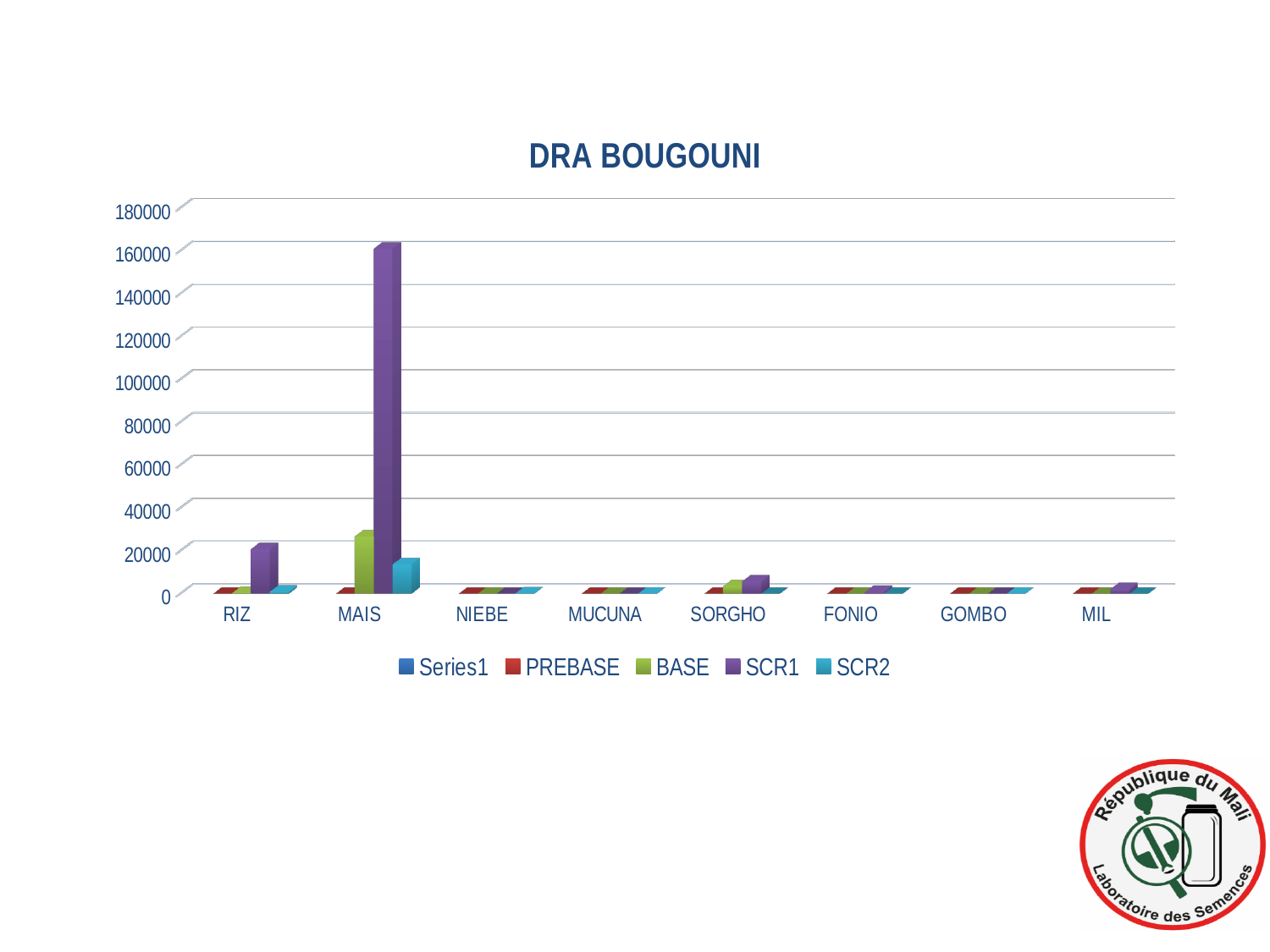
Which colour represents the SCR1 series in the legend? purple Is the SCR2 value for MAIS greater or less than 20000? less How many categories are shown on the x axis of the chart? 8 What kind of chart is shown on the slide? bar chart Which category has the highest SCR1 value? MAIS How many series does the legend list? 5 Which series has the tallest bar for MAIS? SCR1 Is the SCR1 value for RIZ greater or less than 40000? less Which is larger, the SCR1 value for MAIS or the SCR1 value for RIZ? MAIS Is the BASE value for MAIS greater or less than 40000? less What is the title of the chart? DRA BOUGOUNI